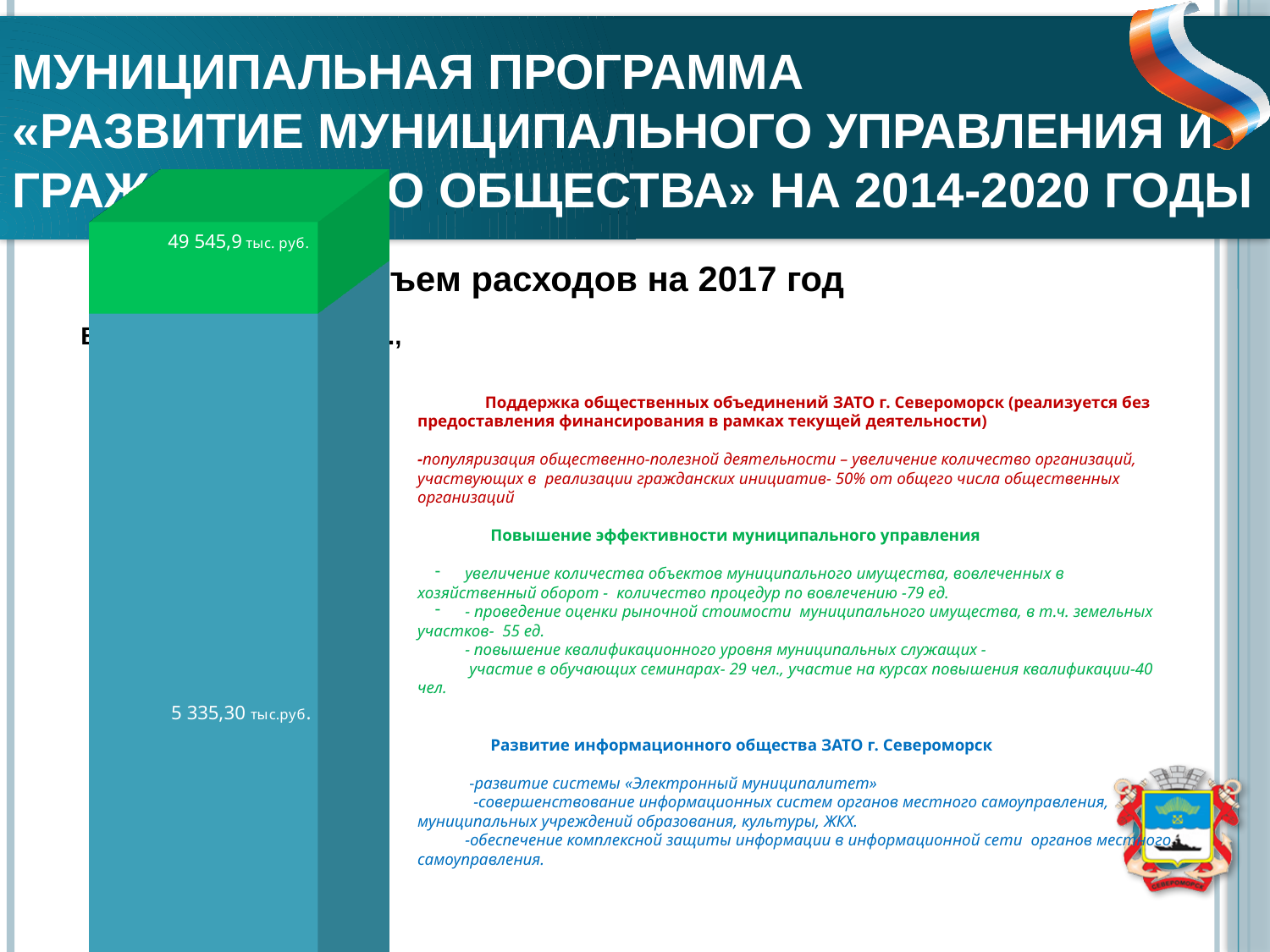
According to the printed labels, which segment has the larger value, the green one or the blue one? green Which year do the expenditures shown in the chart refer to, according to the chart heading? 2017 What unit is used for the values printed on the bar chart? тыс. руб. What value is printed on the blue (bottom) segment of the bar chart? 5 335,30 тыс.руб. How many labelled segments does the stacked bar contain? 2 What kind of chart is shown on the left of the slide? bar chart What is the difference between the green segment value (49 545,9) and the blue segment value (5 335,30), in тыс. руб.? 44 210,6 What value is printed on the green (top) segment of the bar chart? 49 545,9 тыс. руб. What is the total of the two labelled segments of the stacked bar, in тыс. руб.? 54 881,2